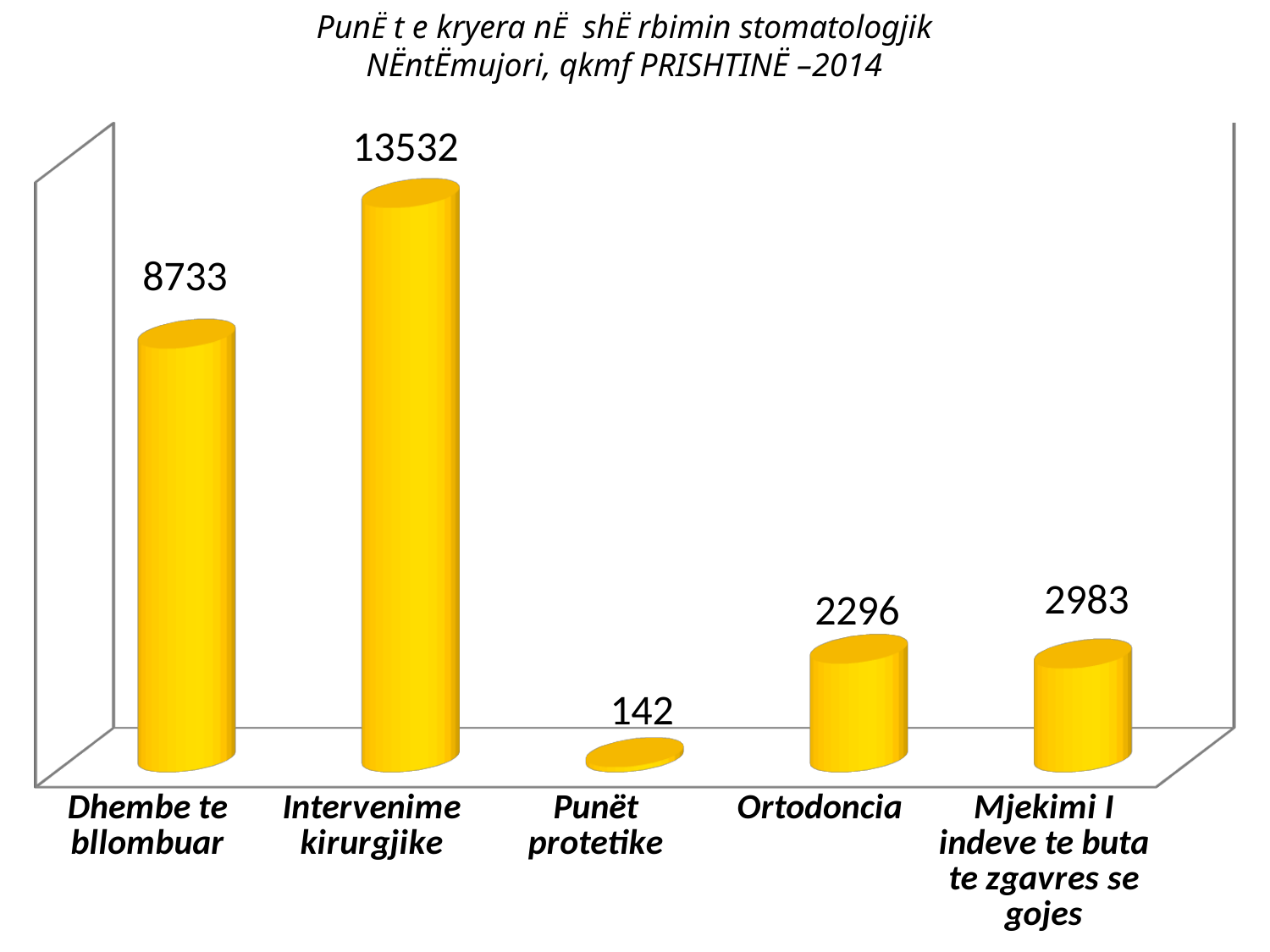
Which is larger, the value for Ortodoncia or the value for Mjekimi I indeve te buta te zgavres se gojes? Mjekimi I indeve te buta te zgavres se gojes What kind of chart is shown on the slide? Bar chart What is the difference between the values for Intervenime kirurgjike and Dhembe te bllombuar? 4799 How many categories are shown in the chart? 5 What is the value for Mjekimi I indeve te buta te zgavres se gojes? 2983 What is the value for Ortodoncia? 2296 What is the value for Punët protetike? 142 Which category has the highest value? Intervenime kirurgjike What is the value for Intervenime kirurgjike? 13532 What is the value for Dhembe te bllombuar? 8733 What is the difference between the values for Mjekimi I indeve te buta te zgavres se gojes and Ortodoncia? 687 Which category has the lowest value? Punët protetike